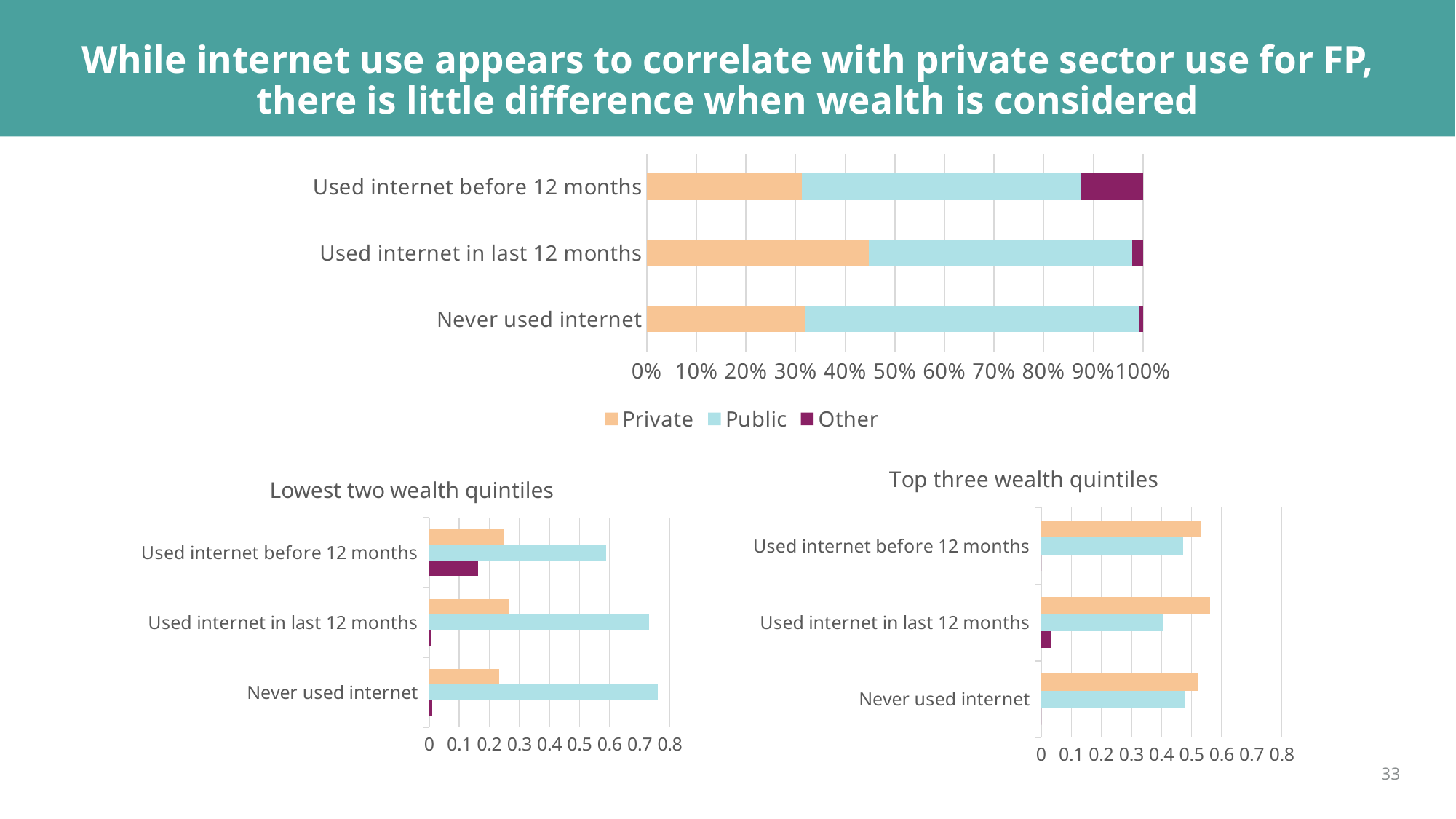
In the top chart, which category has the largest Other segment? Used internet before 12 months In the 'Top three wealth quintiles' chart, which category has the lowest Public value? Used internet in last 12 months What kind of chart is the top chart on the slide? stacked bar chart In the top chart, which category has the largest Private segment? Used internet in last 12 months In the top chart, is the Private share for 'Used internet in last 12 months' greater or less than 40%? greater In the 'Lowest two wealth quintiles' chart, is the Other value for 'Used internet before 12 months' greater or less than 0.2? less In the 'Lowest two wealth quintiles' chart, which category has the lowest Public value? Used internet before 12 months In the 'Top three wealth quintiles' chart, which is larger for 'Never used internet': the Private value or the Public value? Private In the 'Lowest two wealth quintiles' chart, is the Public value for 'Used internet in last 12 months' greater or less than 0.7? greater How many series does the legend of the top chart list? 3 How many categories are shown in the 'Lowest two wealth quintiles' chart? 3